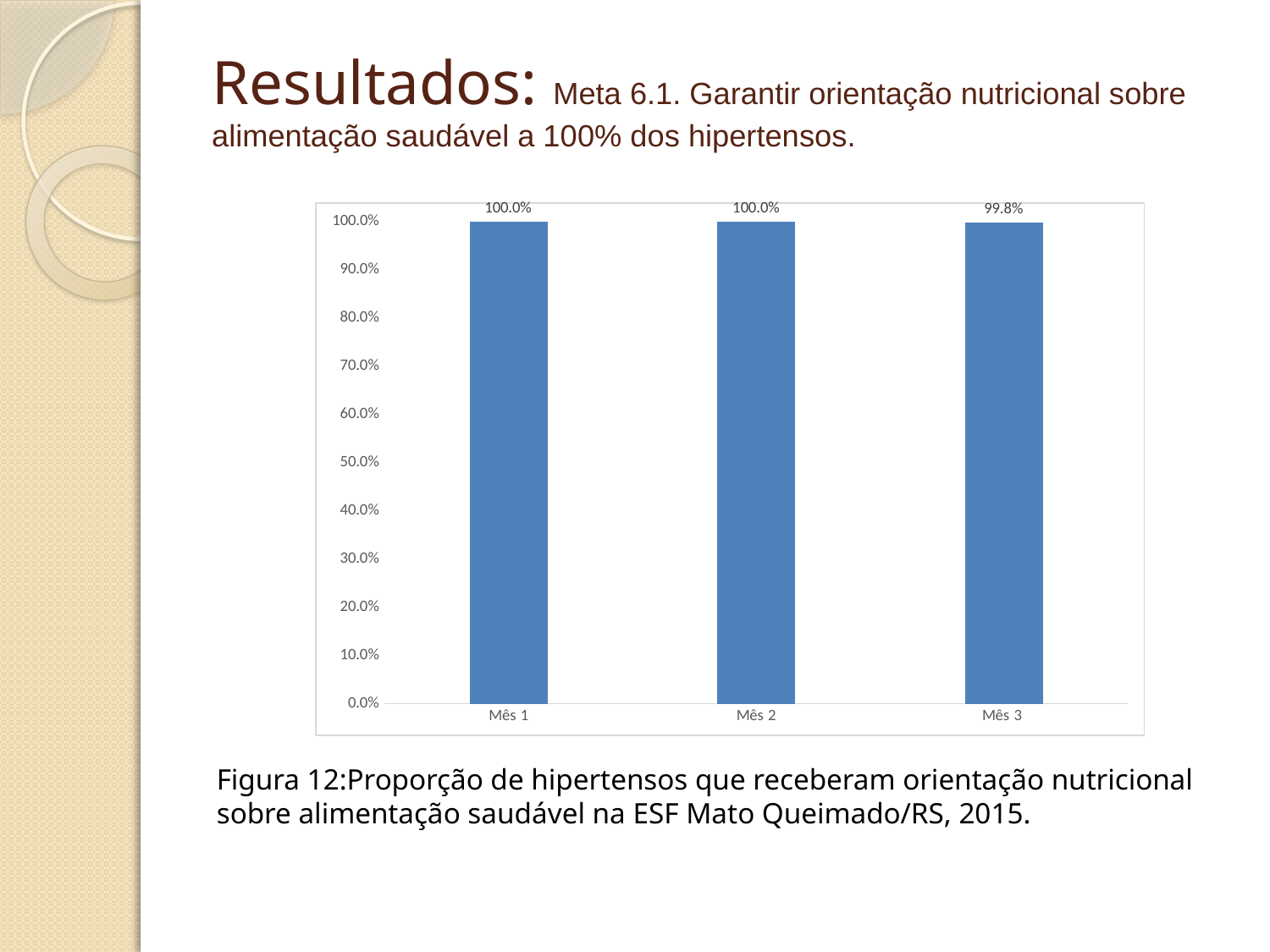
Which month has the lowest value? Mês 3 What is the value for Mês 2? 100.0% What kind of chart is shown on the slide? Bar chart What is the highest value shown on the y axis? 100.0% What is the value for Mês 3? 99.8% Is the value for Mês 2 greater or less than 50.0%? greater What is the difference between the values for Mês 1 and Mês 3? 0.2% What colour are the bars in the chart? Blue What is the value for Mês 1? 100.0% How many months are shown on the x axis? 3 Is the value for Mês 3 greater or less than 90.0%? greater Do the values rise or fall from Mês 2 to Mês 3? Fall